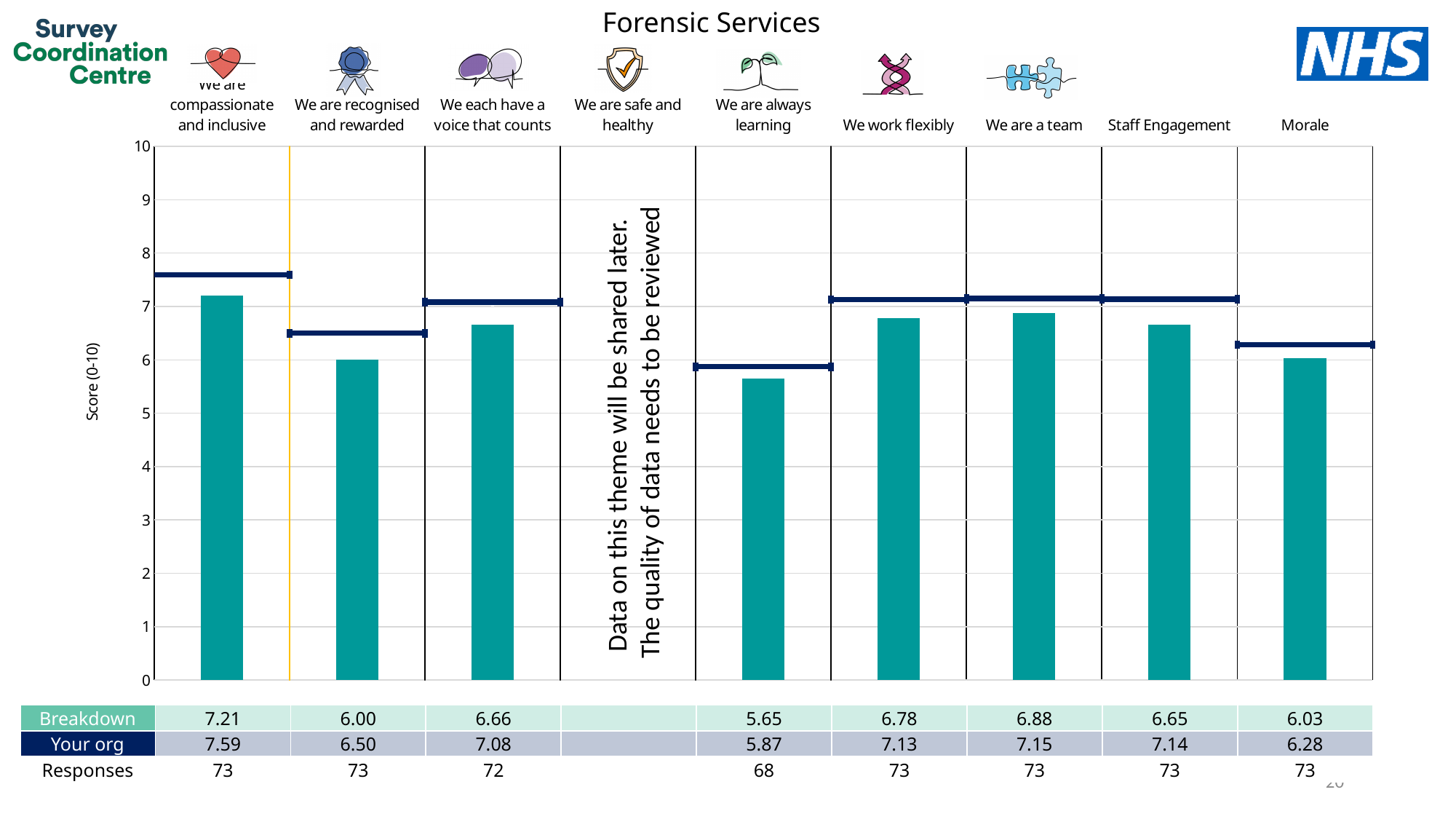
Which theme has the highest Breakdown score? We are compassionate and inclusive What is the Your org score for 'We each have a voice that counts'? 7.08 Which has the higher Breakdown score: 'We work flexibly' or 'We are a team'? We are a team What is the title of the chart? Forensic Services What is the Breakdown score for 'We are compassionate and inclusive'? 7.21 Which theme has the lowest Breakdown score? We are always learning How many responses are recorded for 'We are always learning'? 68 What is the Breakdown score for Morale? 6.03 What is the difference between the Your org score and the Breakdown score for 'We are compassionate and inclusive'? 0.38 Is the Breakdown bar for 'We are always learning' greater or less than 6? less What kind of chart is shown on the slide? Bar chart How many themes have a Breakdown bar plotted on the chart? 8